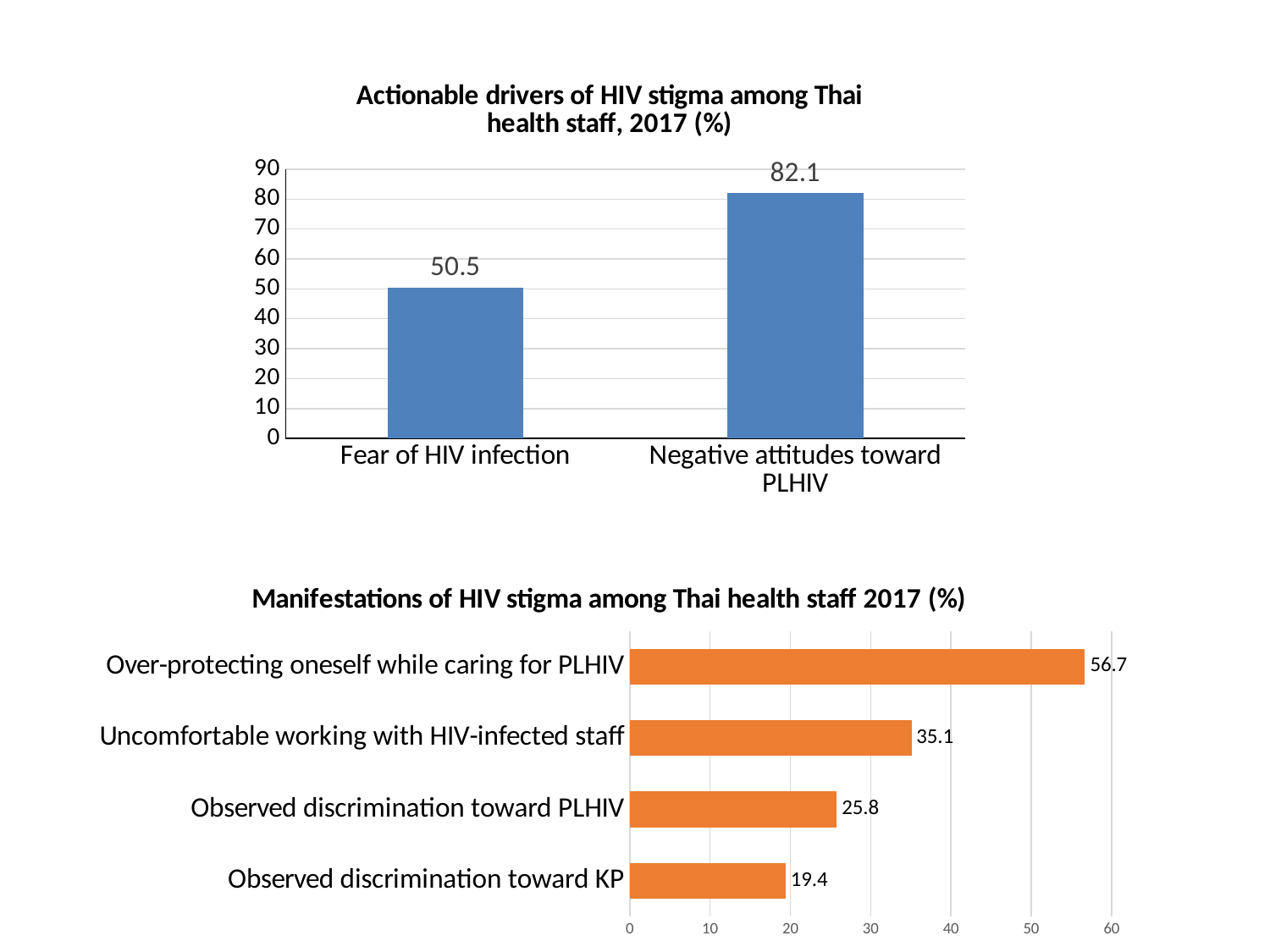
In the 'Manifestations of HIV stigma among Thai health staff 2017 (%)' chart, how many categories are shown? 4 In the 'Manifestations of HIV stigma among Thai health staff 2017 (%)' chart, what is the value for Over-protecting oneself while caring for PLHIV? 56.7 In the 'Manifestations of HIV stigma among Thai health staff 2017 (%)' chart, what is the difference between Uncomfortable working with HIV-infected staff and Observed discrimination toward PLHIV? 9.3 In the 'Actionable drivers of HIV stigma among Thai health staff, 2017 (%)' chart, how many categories are shown? 2 In the 'Actionable drivers of HIV stigma among Thai health staff, 2017 (%)' chart, what is the value for Negative attitudes toward PLHIV? 82.1 In the 'Actionable drivers of HIV stigma among Thai health staff, 2017 (%)' chart, which category has the highest value? Negative attitudes toward PLHIV In the 'Manifestations of HIV stigma among Thai health staff 2017 (%)' chart, which is larger: Uncomfortable working with HIV-infected staff or Observed discrimination toward PLHIV? Uncomfortable working with HIV-infected staff In the 'Manifestations of HIV stigma among Thai health staff 2017 (%)' chart, which category has the lowest value? Observed discrimination toward KP What kind of chart is the 'Actionable drivers of HIV stigma among Thai health staff, 2017 (%)' chart? Bar chart In the 'Manifestations of HIV stigma among Thai health staff 2017 (%)' chart, what is the value for Observed discrimination toward KP? 19.4 In the 'Actionable drivers of HIV stigma among Thai health staff, 2017 (%)' chart, what is the difference between Negative attitudes toward PLHIV and Fear of HIV infection? 31.6 In the 'Actionable drivers of HIV stigma among Thai health staff, 2017 (%)' chart, what is the value for Fear of HIV infection? 50.5